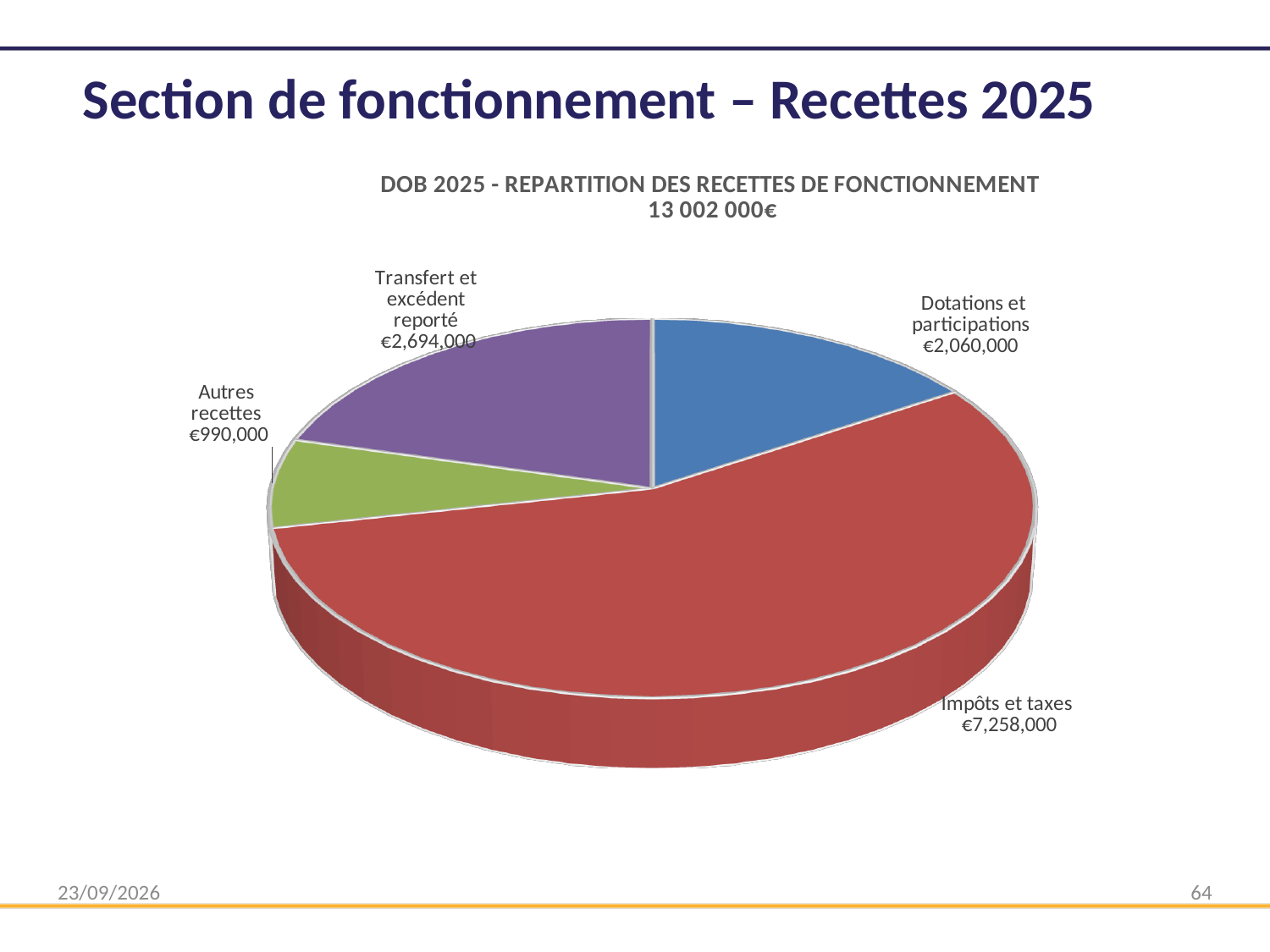
What is the value for Dotations et participations? €2,060,000 What is the value for Impôts et taxes? €7,258,000 What is the difference between Impôts et taxes and Transfert et excédent reporté? €4,564,000 What total amount is stated in the chart title? 13 002 000€ Which category has the largest slice of the pie? Impôts et taxes Which is larger, Transfert et excédent reporté or Dotations et participations? Transfert et excédent reporté How many categories are shown in the pie chart? 4 What is the value for Autres recettes? €990,000 What is the difference between Dotations et participations and Autres recettes? €1,070,000 What is the value for Transfert et excédent reporté? €2,694,000 Which category has the smallest slice of the pie? Autres recettes What kind of chart is shown on the slide? Pie chart